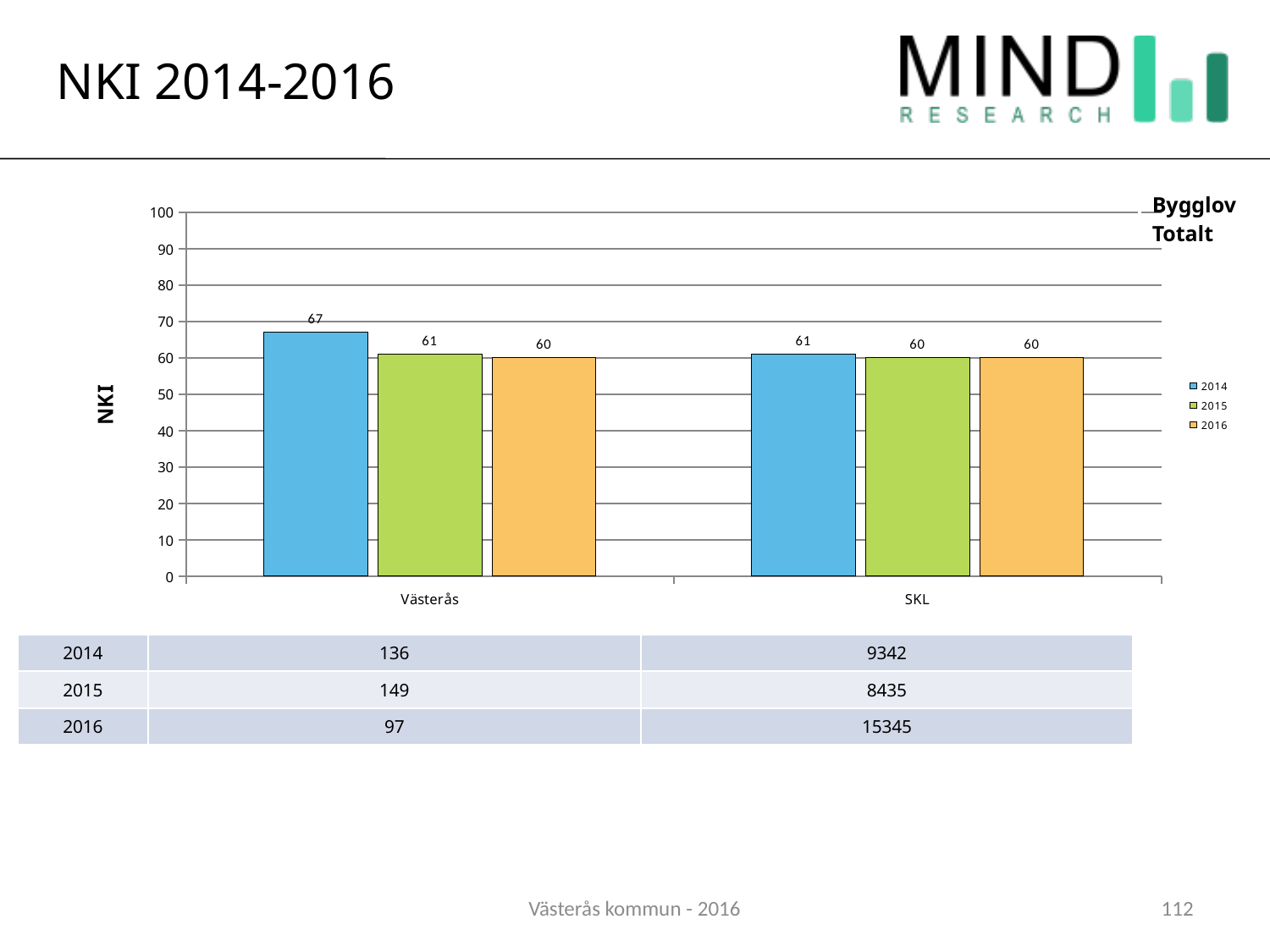
What kind of chart is shown on the slide? Bar chart Which is larger, the 2014 NKI value for Västerås or the 2014 NKI value for SKL? Västerås How many series does the chart legend list? 3 What is the NKI value for Västerås in 2015? 61 What is the NKI value for SKL in 2014? 61 What is the difference between the 2014 and 2016 NKI values for Västerås? 7 What is the difference between the 2014 NKI values for Västerås and SKL? 6 What is the NKI value for SKL in 2016? 60 Do the NKI values for Västerås rise or fall from 2014 to 2016? Fall What is the NKI value for Västerås in 2014? 67 Which year has the highest NKI value for Västerås? 2014 How many categories are shown on the x axis of the chart? 2